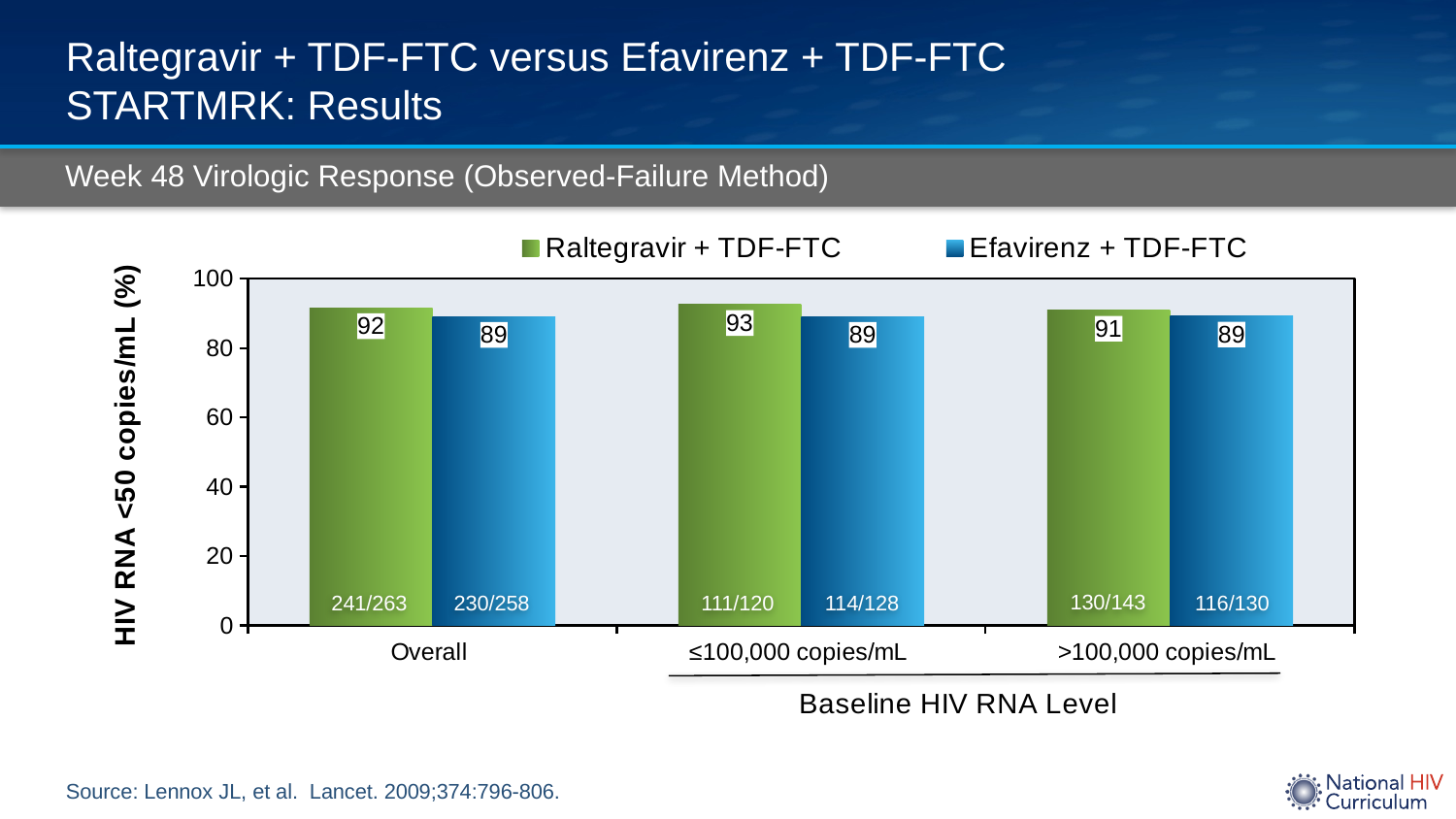
What is the value for Raltegravir + TDF-FTC in the Overall category? 92 Is the value for Efavirenz + TDF-FTC in the Overall category greater or less than 80? greater What is the label of the y axis? HIV RNA <50 copies/mL (%) What is the difference between Raltegravir + TDF-FTC and Efavirenz + TDF-FTC in the ≤100,000 copies/mL category? 4 What is the value for Efavirenz + TDF-FTC in the >100,000 copies/mL category? 89 Which category has the lowest value for Raltegravir + TDF-FTC? >100,000 copies/mL How many series does the legend list? 2 What is the value for Raltegravir + TDF-FTC in the ≤100,000 copies/mL category? 93 In the Overall category, which series has the larger value, Raltegravir + TDF-FTC or Efavirenz + TDF-FTC? Raltegravir + TDF-FTC How many categories are shown on the x axis? 3 What kind of chart is shown on the slide? Bar chart Which category has the highest value for Raltegravir + TDF-FTC? ≤100,000 copies/mL